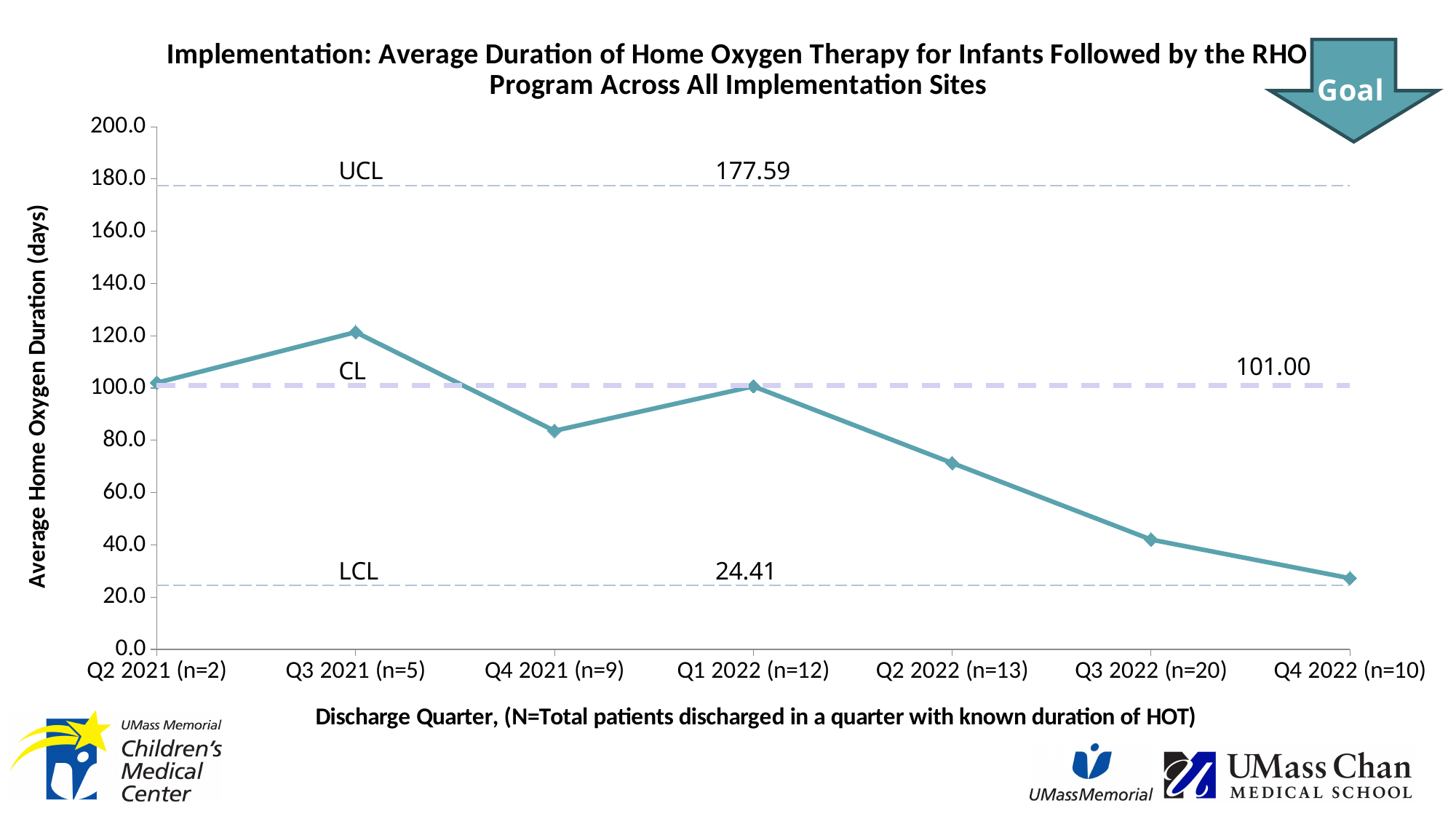
Which discharge quarter has the highest average home oxygen duration? Q3 2021 (n=5) Is the value for Q2 2022 (n=13) greater or less than 80? less From Q3 2021 to Q4 2022, do the plotted values generally rise or fall? fall What kind of chart is shown on the slide? line chart What is the value of the UCL (upper control limit) shown on the chart? 177.59 How many discharge quarters are plotted on the x axis? 7 What is the value of the CL (center line) shown on the chart? 101.00 Is the value for Q3 2021 (n=5) greater or less than 100? greater Is the value for Q4 2022 (n=10) greater or less than 40? less Which discharge quarter has the lowest average home oxygen duration? Q4 2022 (n=10) What is the value of the LCL (lower control limit) shown on the chart? 24.41 Which is larger, the value for Q4 2021 (n=9) or the value for Q2 2022 (n=13)? Q4 2021 (n=9)